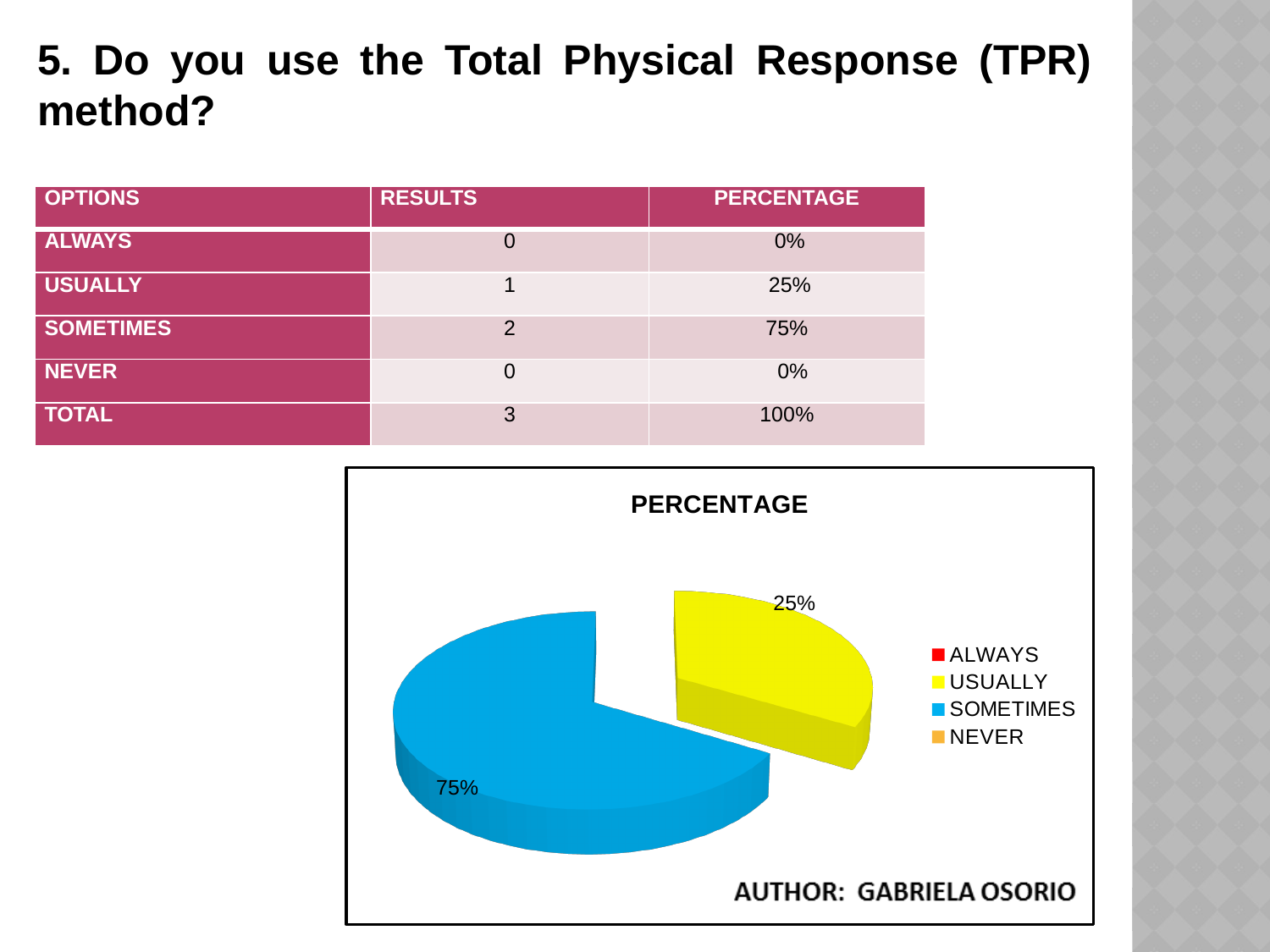
Which category has the largest slice in the pie chart? SOMETIMES What share of the pie does the USUALLY slice represent? 25% What percentage does the USUALLY slice show in the pie chart? 25% What kind of chart is shown on the slide? Pie chart Which slice is larger, SOMETIMES or USUALLY? SOMETIMES What is the title of the chart? PERCENTAGE How many slices are visibly plotted in the pie chart? 2 What is the difference in percentage points between the SOMETIMES and USUALLY slices? 50% What percentage does the SOMETIMES slice show in the pie chart? 75% What colour is the SOMETIMES slice in the pie chart? Blue How many entries does the chart legend list? 4